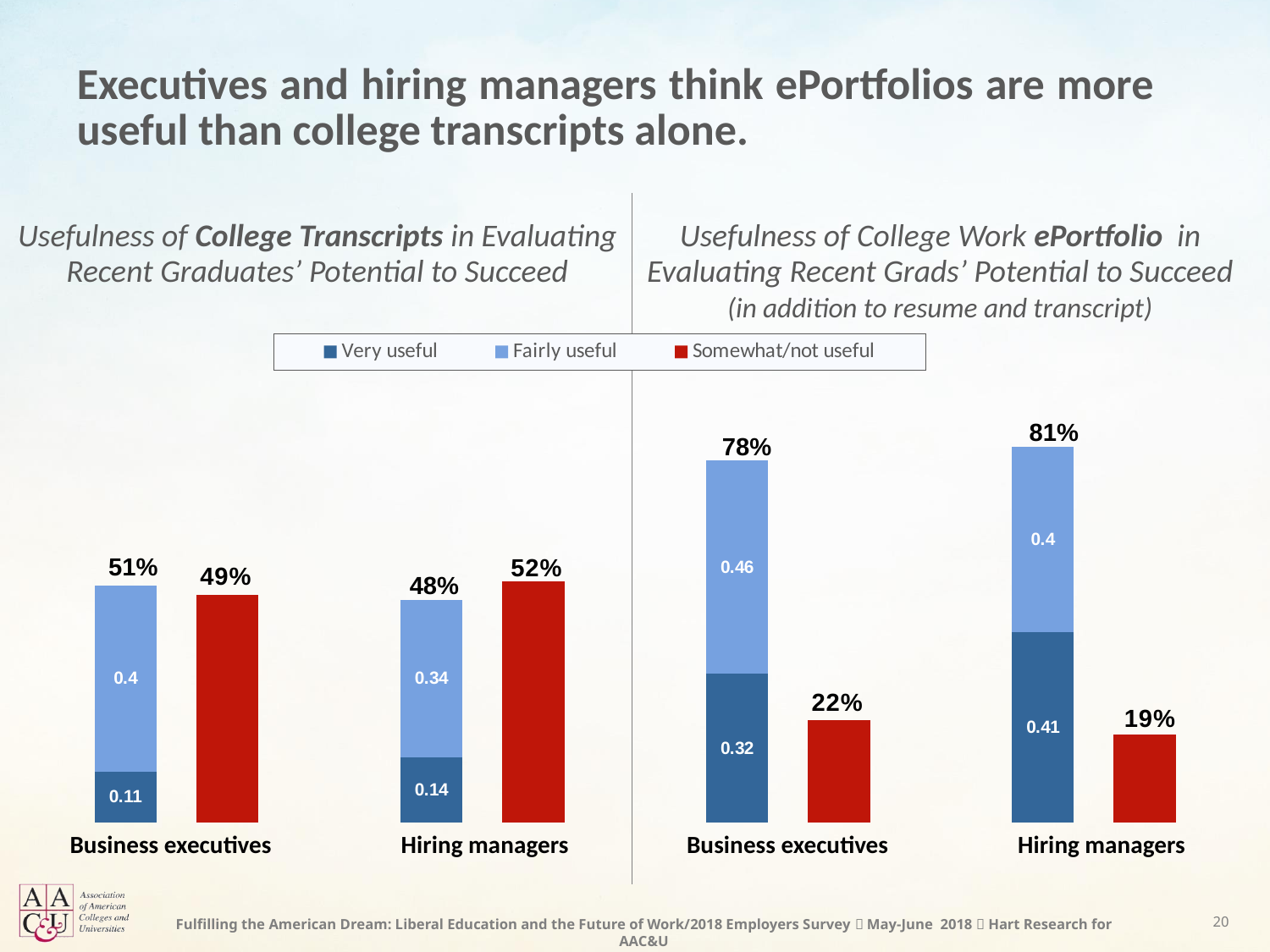
In the College Transcripts chart on the left, what is the combined total of the stacked bar for Business executives? 51% In the College Transcripts chart on the left, what is the 'Very useful' value for Business executives? 0.11 In the ePortfolio chart on the right, what is the combined total of the stacked bar for Hiring managers? 81% In the College Transcripts chart on the left, what is the difference between the 'Somewhat/not useful' values for Hiring managers and Business executives? 3% In the College Transcripts chart on the left, what is the 'Fairly useful' value for Hiring managers? 0.34 In the ePortfolio chart on the right, what is the 'Somewhat/not useful' value for Business executives? 22% What kind of chart is used on the slide? Bar chart In the ePortfolio chart on the right, is the 'Somewhat/not useful' value for Hiring managers greater or less than the 'Somewhat/not useful' value for Business executives? less In the ePortfolio chart on the right, what is the 'Very useful' value for Hiring managers? 0.41 Which colour represents 'Somewhat/not useful' in the legend? Red In the ePortfolio chart on the right, which group has the higher 'Very useful' value, Business executives or Hiring managers? Hiring managers How many series does the legend list? 3